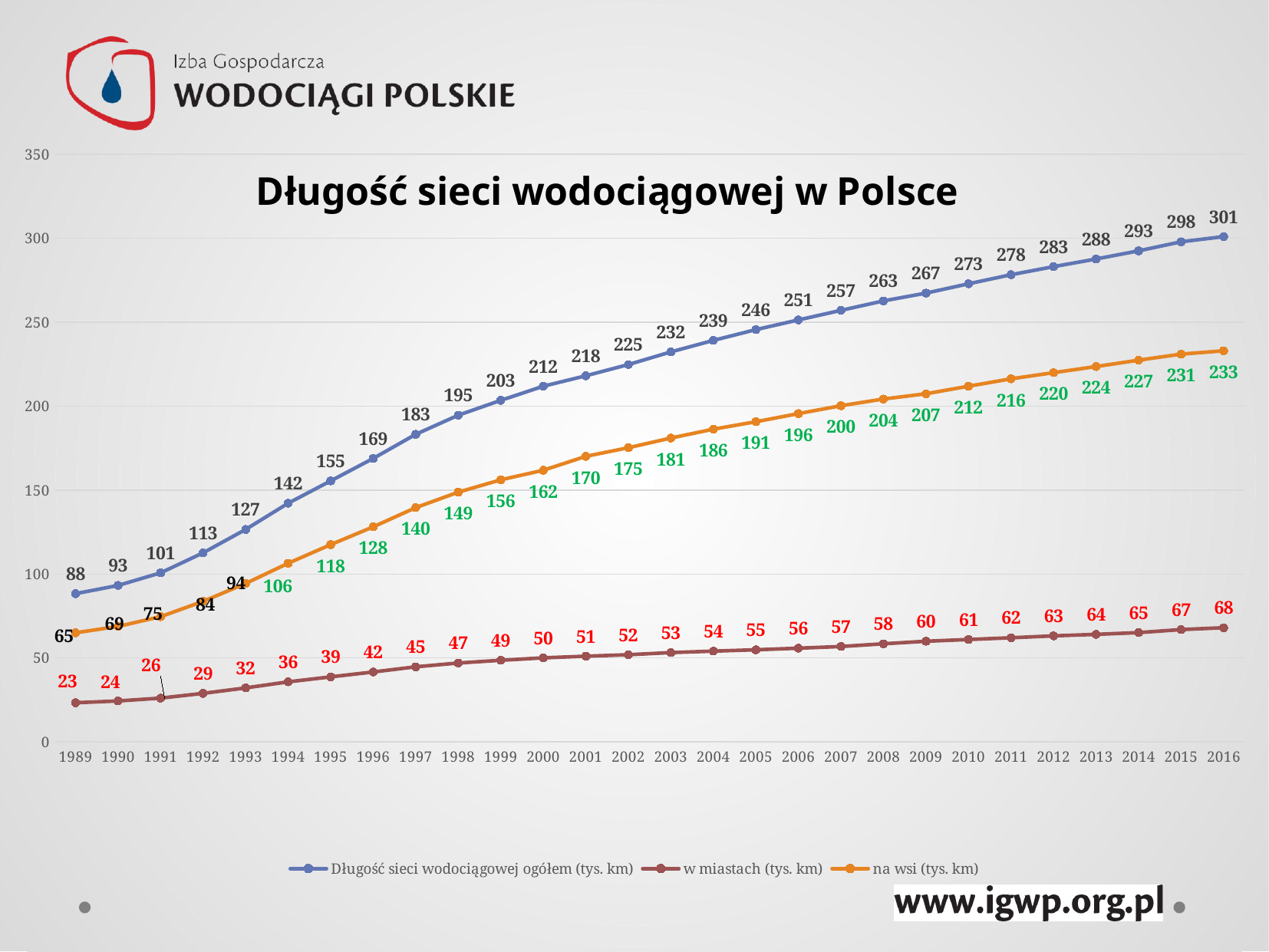
In which year is 'Długość sieci wodociągowej ogółem (tys. km)' lowest? 1989 What is the value of 'Długość sieci wodociągowej ogółem (tys. km)' in 2016? 301 What is the value of 'na wsi (tys. km)' in 2000? 162 How many years are shown on the x axis? 28 What is the value of 'w miastach (tys. km)' in 1989? 23 In which year is 'na wsi (tys. km)' highest? 2016 Which is larger in 1993: 'na wsi (tys. km)' or 'w miastach (tys. km)'? na wsi (tys. km) What is the difference between 'na wsi (tys. km)' and 'w miastach (tys. km)' in 2016? 165 What type of chart is shown on the slide? line chart Does 'w miastach (tys. km)' rise or fall from 1989 to 2016? rise How many series does the legend list? 3 What is the title of the chart? Długość sieci wodociągowej w Polsce